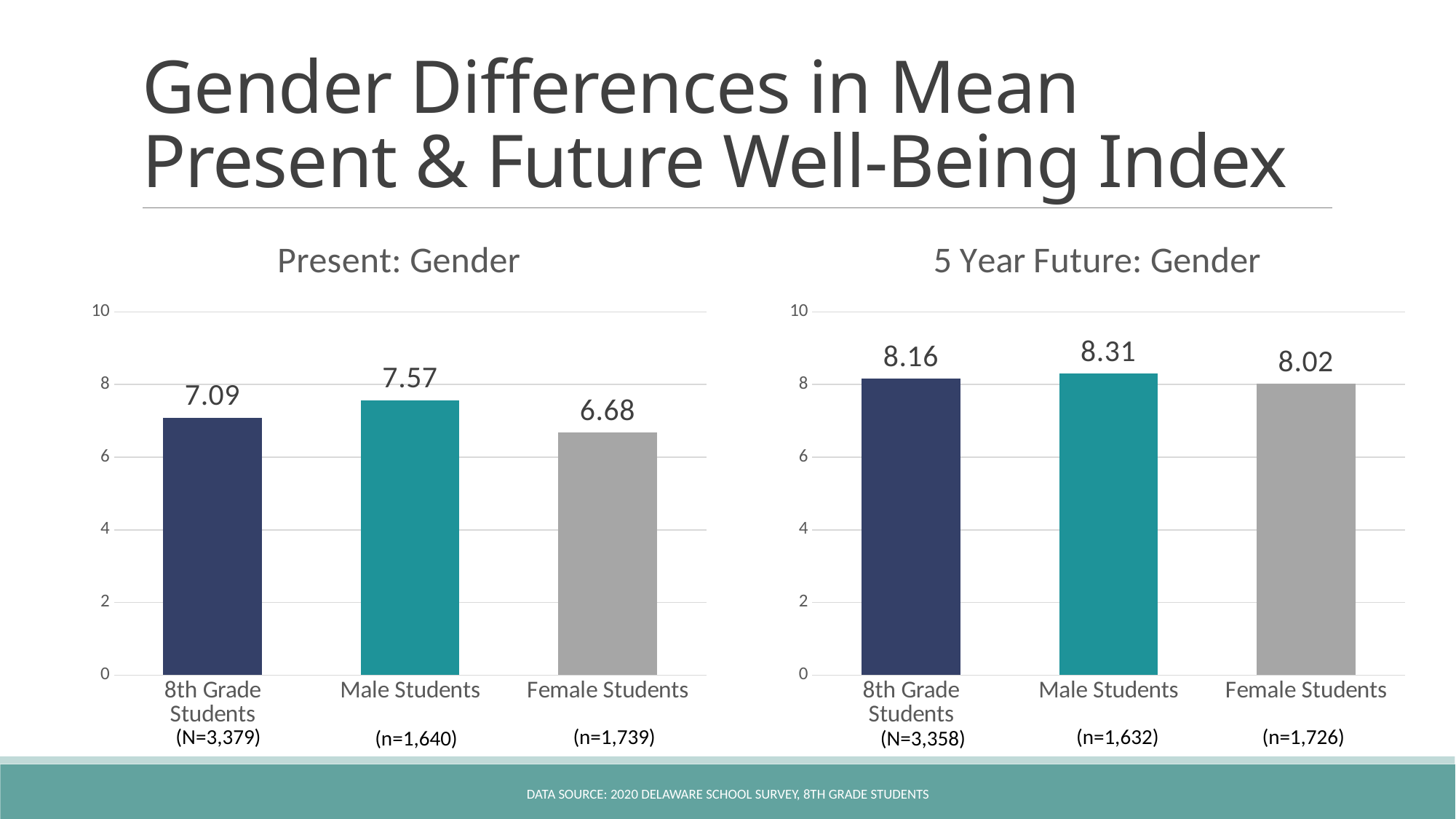
In the 'Present: Gender' chart, what is the value for Female Students? 6.68 How many categories are shown in the '5 Year Future: Gender' chart? 3 In the 'Present: Gender' chart, which is larger: the value for 8th Grade Students or the value for Female Students? 8th Grade Students In the 'Present: Gender' chart, what colour is the bar for Male Students? Teal In the 'Present: Gender' chart, what is the difference between the values for Male Students and Female Students? 0.89 In the 'Present: Gender' chart, which category has the highest value? Male Students In the 'Present: Gender' chart, what is the value for Male Students? 7.57 In the '5 Year Future: Gender' chart, what is the difference between the values for Male Students and 8th Grade Students? 0.15 In the '5 Year Future: Gender' chart, what is the value for Female Students? 8.02 In the '5 Year Future: Gender' chart, which category has the lowest value? Female Students What kind of chart is the 'Present: Gender' chart? Bar chart In the '5 Year Future: Gender' chart, what is the value for 8th Grade Students? 8.16